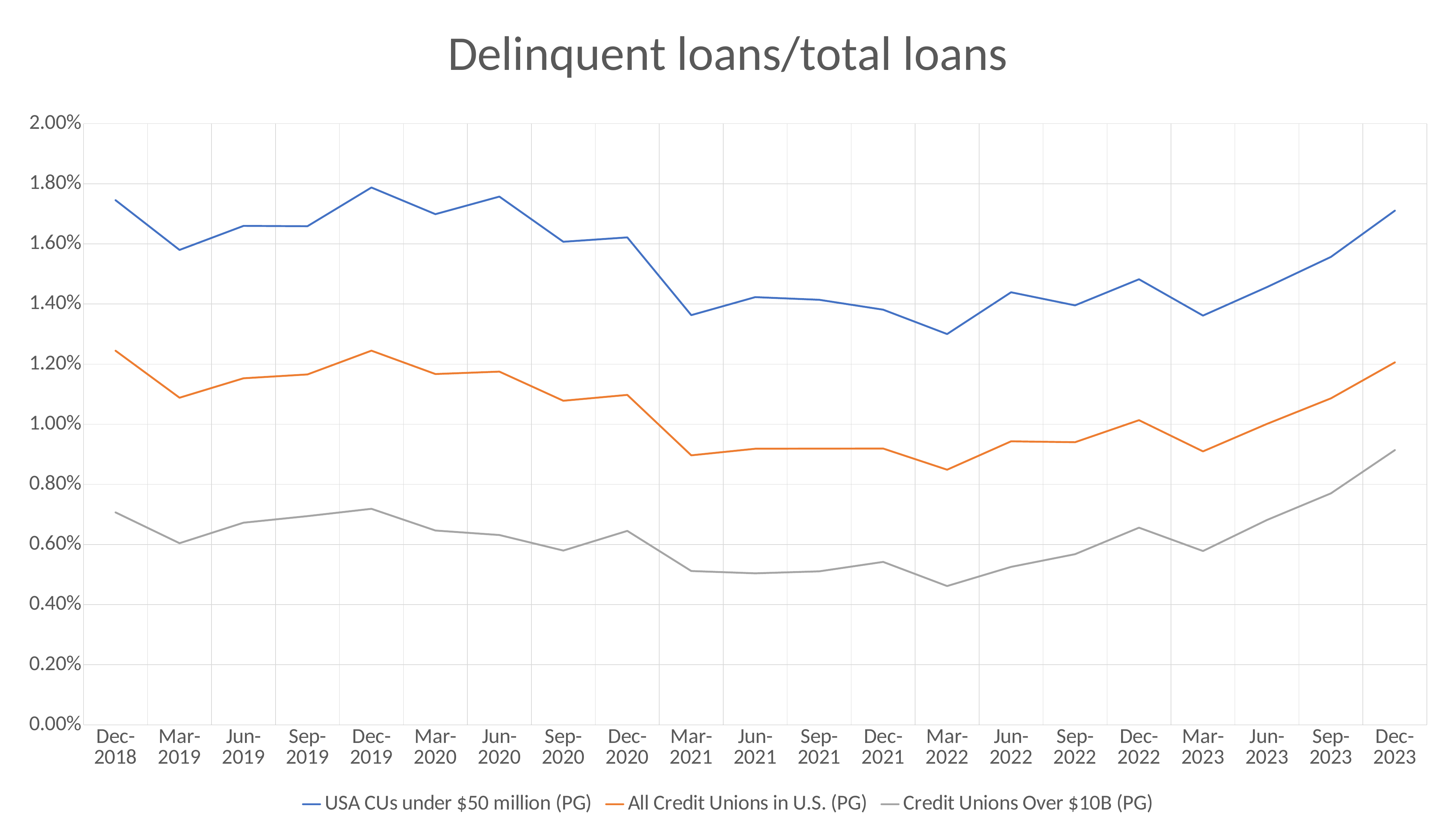
What is the title of the chart? Delinquent loans/total loans Is the value for USA CUs under $50 million (PG) at Dec-2019 greater or less than 1.60%? greater Does the Credit Unions Over $10B (PG) series rise or fall from Mar-2023 to Dec-2023? Rise How many time points are shown on the x axis? 21 Which series is plotted with the orange line? All Credit Unions in U.S. (PG) At which date does the Credit Unions Over $10B (PG) series reach its highest value? Dec-2023 What kind of chart is shown on the slide? Line chart How many series does the legend list? 3 At which date does the Credit Unions Over $10B (PG) series reach its lowest value? Mar-2022 At which date does the USA CUs under $50 million (PG) series reach its highest value? Dec-2019 At which date does the USA CUs under $50 million (PG) series reach its lowest value? Mar-2022 Is the value for Credit Unions Over $10B (PG) at Mar-2022 greater or less than 0.60%? less